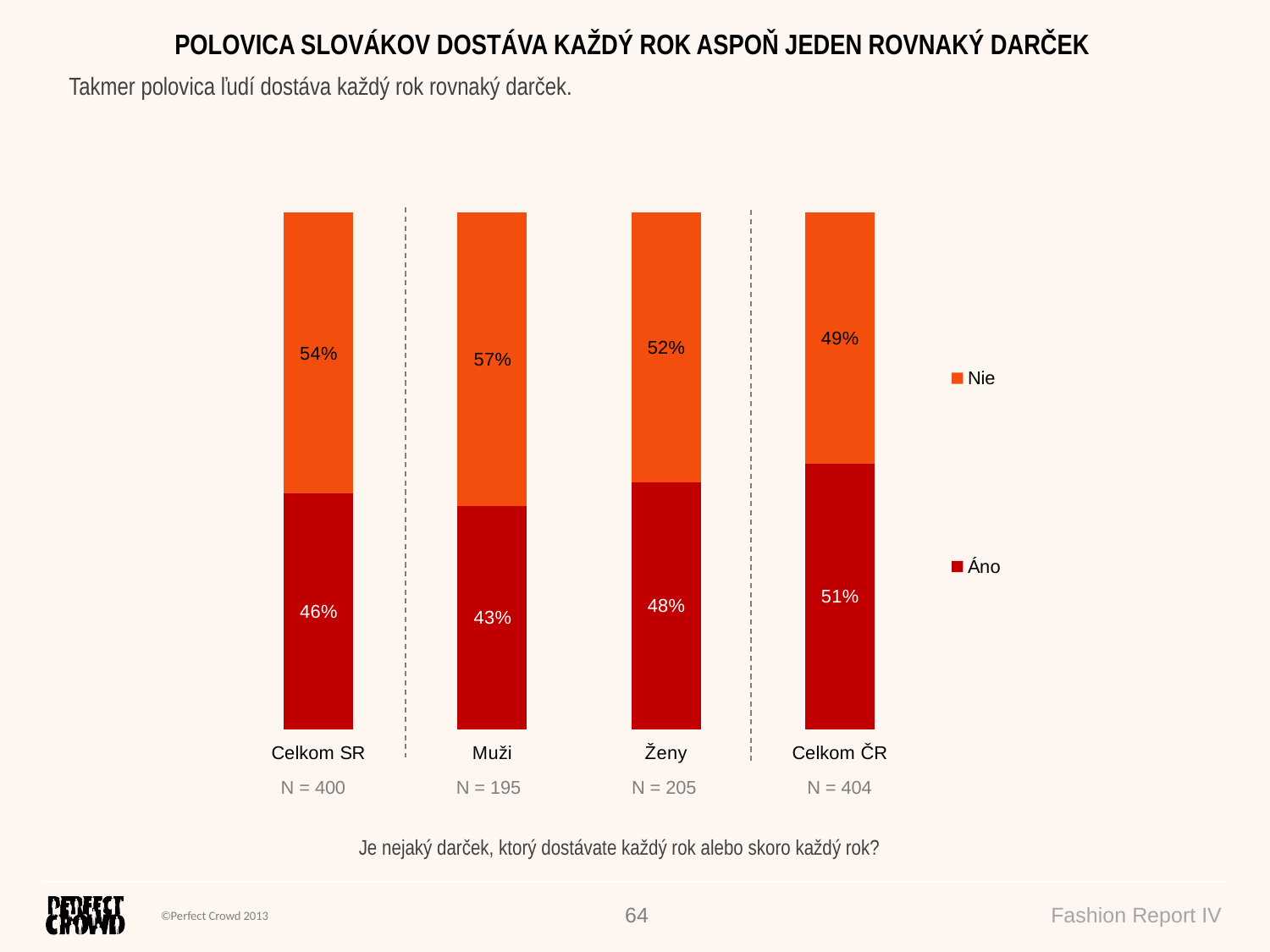
Which category has the lowest "Áno" value? Muži How many series does the legend list? 2 What is the "Nie" value for Ženy? 52% Which is larger, the "Áno" value for Ženy or the "Áno" value for Muži? Ženy How many categories are shown on the x axis? 4 What is the "Áno" value for Celkom ČR? 51% Which category has the highest "Áno" value? Celkom ČR What is the "Áno" value for Celkom SR? 46% What is the sample size (N) shown for Ženy? N = 205 What is the difference between the "Nie" values for Muži and Ženy? 5% What kind of chart is shown on the slide? Stacked bar chart What is the "Nie" value for Muži? 57%